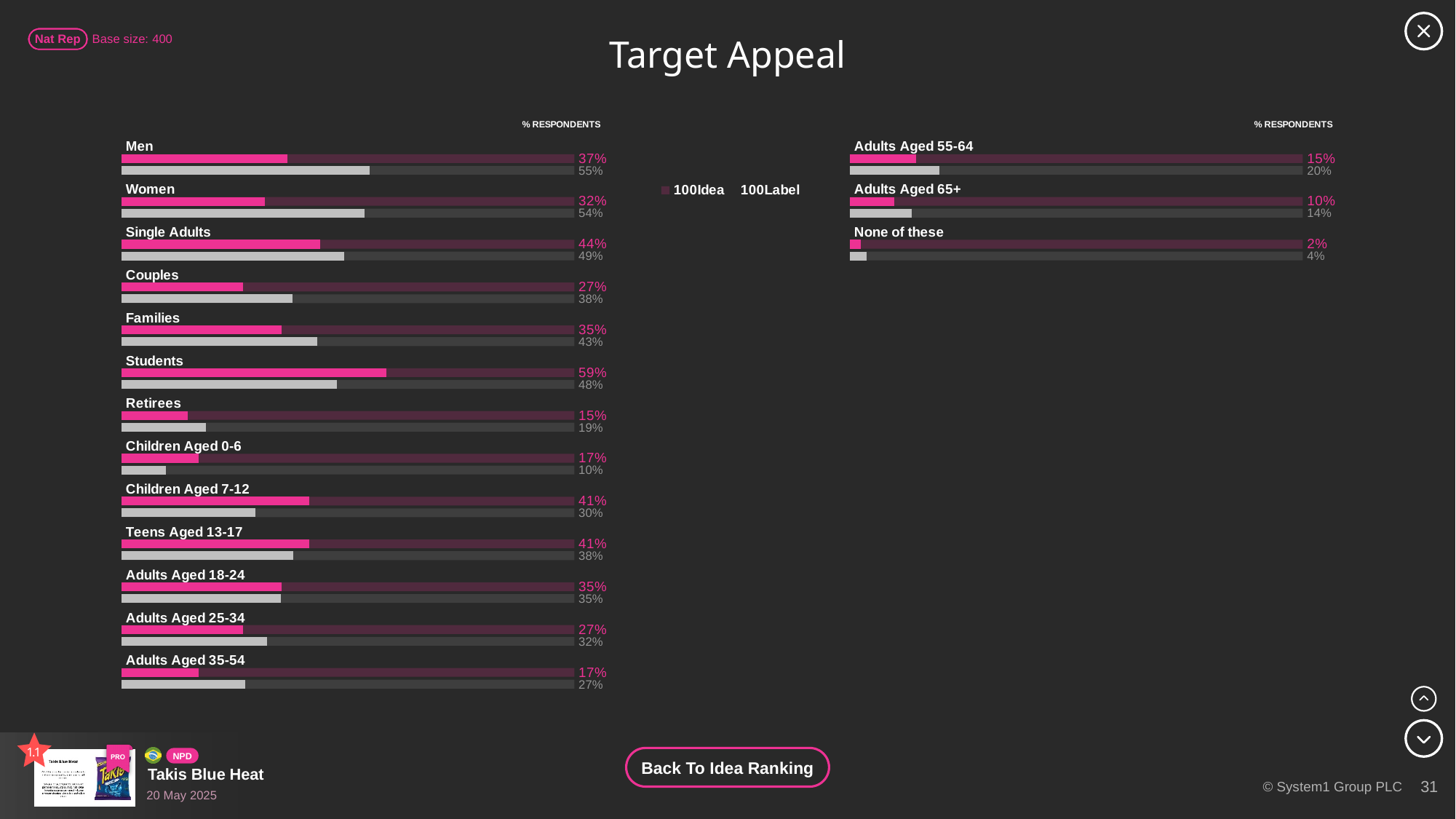
What is the difference between the pink (Idea) value for Students and the pink (Idea) value for Retirees? 44% What kind of chart is shown on the slide? Bar chart Which category has the lowest grey (Label) value? None of these Which category has the highest pink (Idea) value? Students How many series does the legend list? 2 Which is larger for Children Aged 0-6: the pink (Idea) value or the grey (Label) value? Pink (Idea), 17% What is the grey (Label) value for Men? 55% What is the pink (Idea) value for Adults Aged 65+? 10% How many categories are shown on the slide in total? 16 What is the pink (Idea) value for Students? 59% What is the difference between the grey (Label) value and the pink (Idea) value for Men? 18% What is the title of the slide's chart? Target Appeal